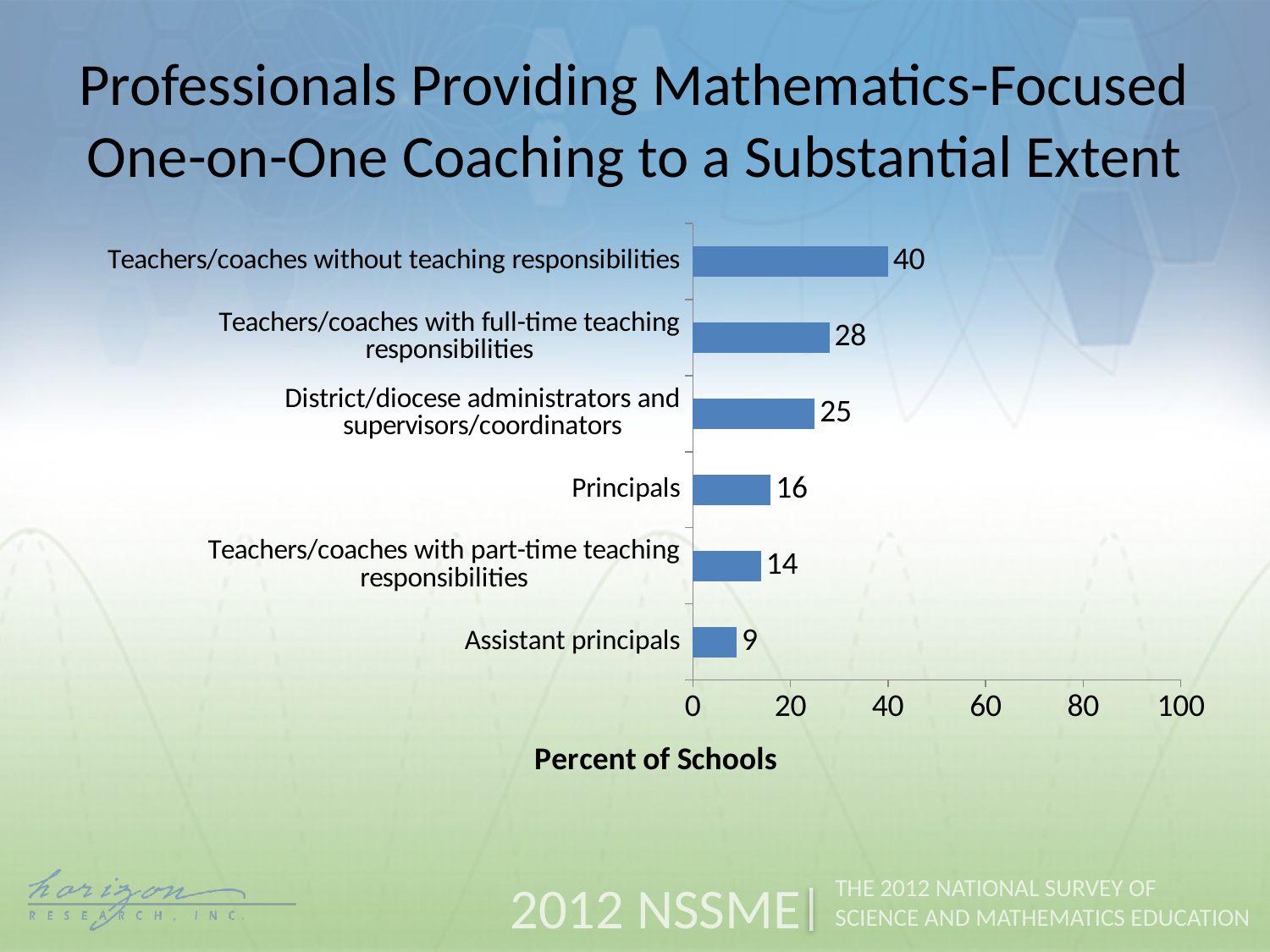
What is the value for Principals? 16 Which is larger: the value for Principals or the value for District/diocese administrators and supervisors/coordinators? District/diocese administrators and supervisors/coordinators What kind of chart is shown on the slide? bar chart Which category has the highest percent of schools? Teachers/coaches without teaching responsibilities What is the value for Assistant principals? 9 What percent of schools is shown for Teachers/coaches without teaching responsibilities? 40 How many categories are shown in the chart? 6 What is the difference between the values for Teachers/coaches with full-time teaching responsibilities and Teachers/coaches with part-time teaching responsibilities? 14 What is the value for District/diocese administrators and supervisors/coordinators? 25 Is the value for Teachers/coaches with full-time teaching responsibilities greater or less than 20? greater What is the label of the horizontal axis? Percent of Schools Which category has the lowest percent of schools? Assistant principals